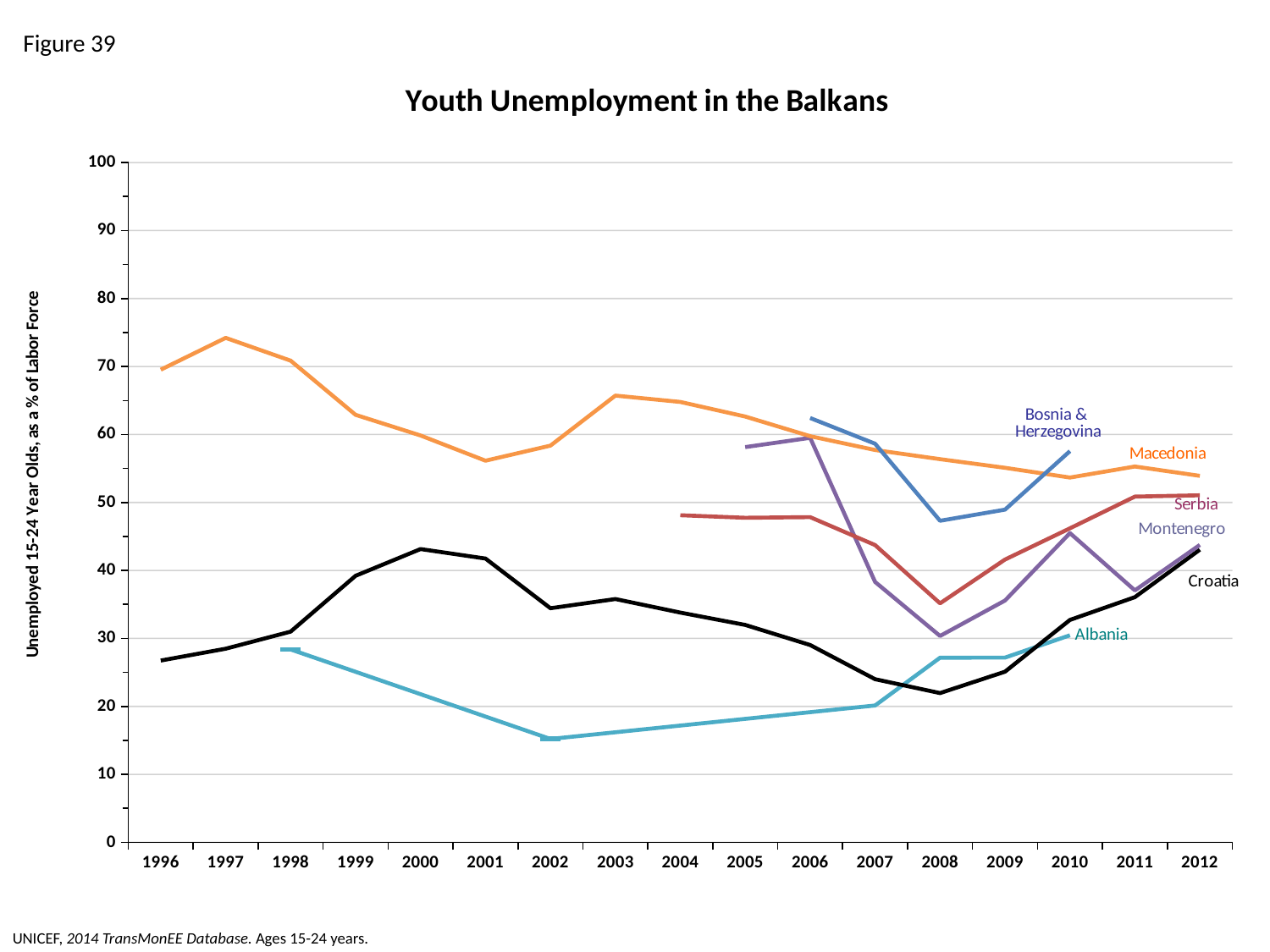
Does Croatia's youth unemployment rise or fall from 2008 to 2012? rise Is the value for Serbia in 2008 greater or less than 30? greater Is the value for Macedonia in 1997 greater or less than 70? greater Which is larger: Croatia's value in 2000 or Croatia's value in 2008? 2000 How many countries are plotted on the chart? 6 What kind of chart is shown on the slide? line chart Which country has the lowest youth unemployment in 2008? Croatia Is the value for Albania in 2002 greater or less than 20? less What is the title of the chart? Youth Unemployment in the Balkans How many years are shown on the x axis? 17 Which country has the highest youth unemployment in 1997? Macedonia